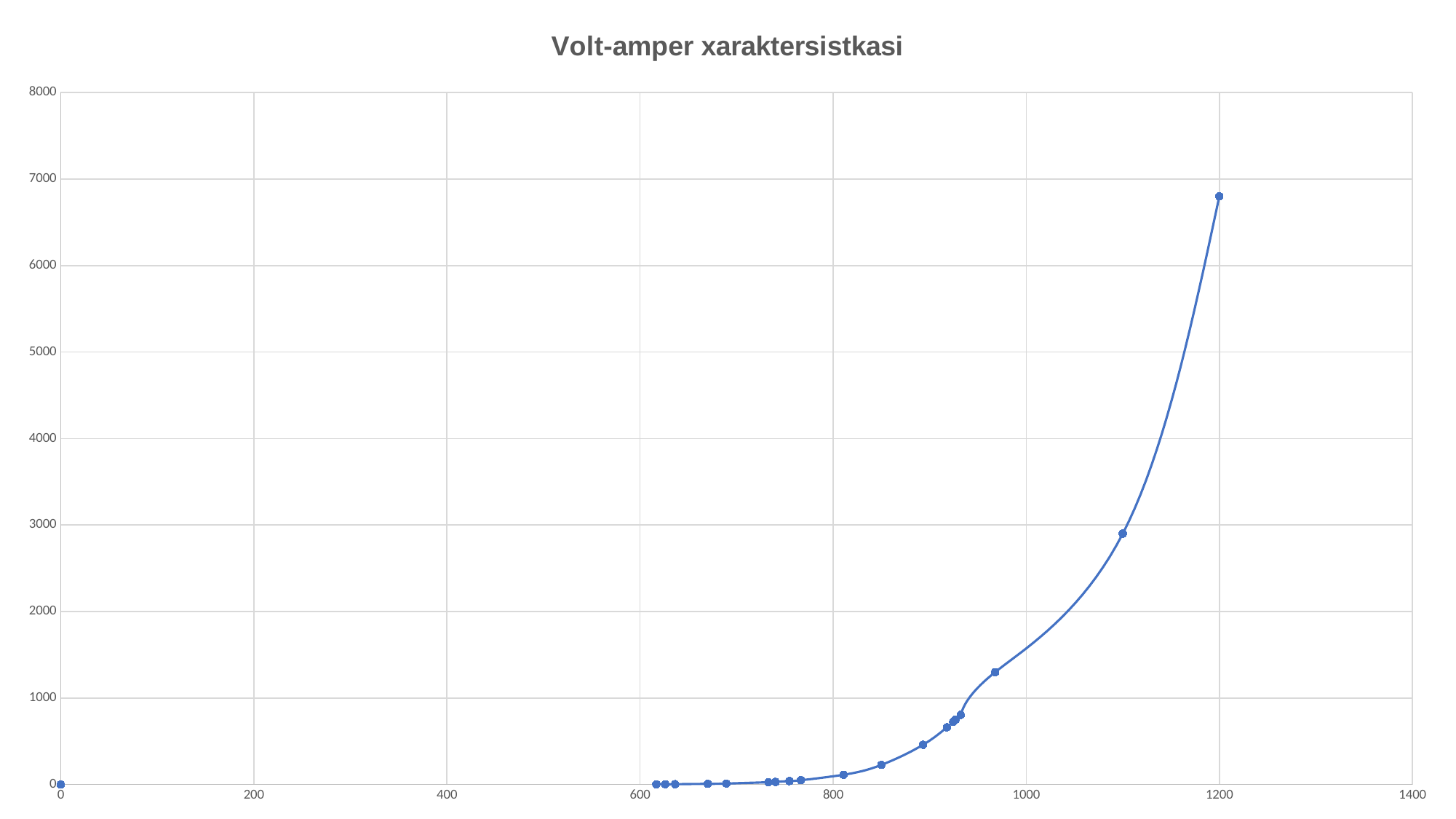
Is the value of the point at x = 1100 greater or less than 2000? greater What kind of chart is shown on the slide? line chart Is the value of the point at x = 1200 greater or less than 7000? less Which of the two points has the larger value: the one at x = 1100 or the one at x = 1200? the one at x = 1200 At which x-axis value does the highest plotted point occur? 1200 Is the value of the point at x = 1100 greater or less than 4000? less What is the maximum value shown on the vertical axis? 8000 What is the title of the chart? Volt-amper xaraktersistkasi Do the plotted values rise or fall as the x-axis value increases? rise